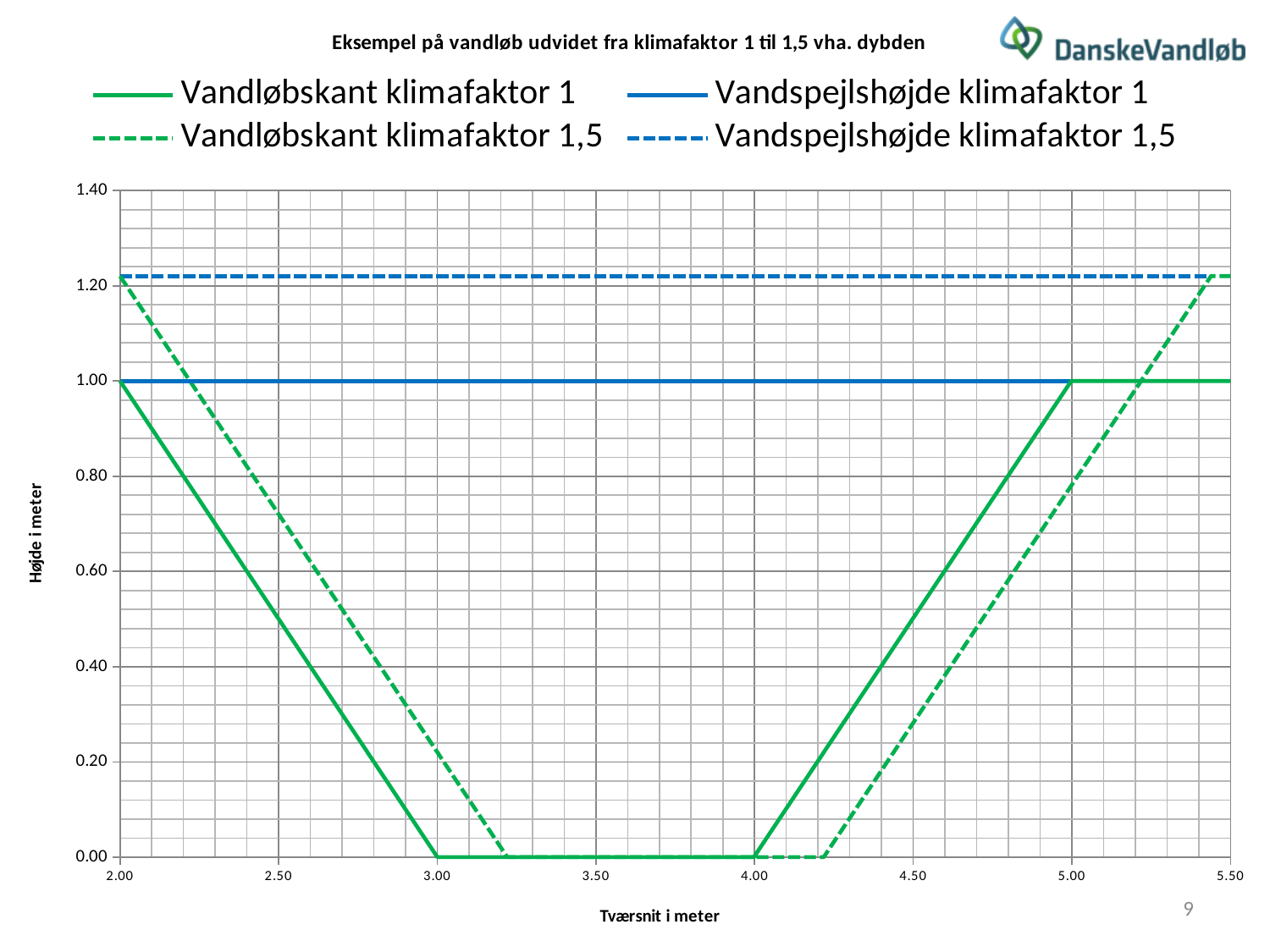
Does Vandløbskant klimafaktor 1 rise or fall between cross-sections 4.00 and 5.00 meters? rise Is the height of Vandløbskant klimafaktor 1,5 at a cross-section of 2.50 meters greater or less than 0.60? greater Is the value of Vandspejlshøjde klimafaktor 1,5 greater or less than 1.20? greater How many series does the legend list? 4 What is the height of Vandløbskant klimafaktor 1 at a cross-section of 5.00 meters? 1.00 What is the value of Vandspejlshøjde klimafaktor 1 in meters? 1.00 What is the title of the horizontal axis? Tværsnit i meter What is the height of Vandløbskant klimafaktor 1 at a cross-section of 3.50 meters? 0.00 At a cross-section of 2.50 meters, which is higher, Vandløbskant klimafaktor 1 or Vandløbskant klimafaktor 1,5? Vandløbskant klimafaktor 1,5 What kind of chart is shown on the slide? line chart What is the title of the vertical axis? Højde i meter Which is higher, Vandspejlshøjde klimafaktor 1 or Vandspejlshøjde klimafaktor 1,5? Vandspejlshøjde klimafaktor 1,5